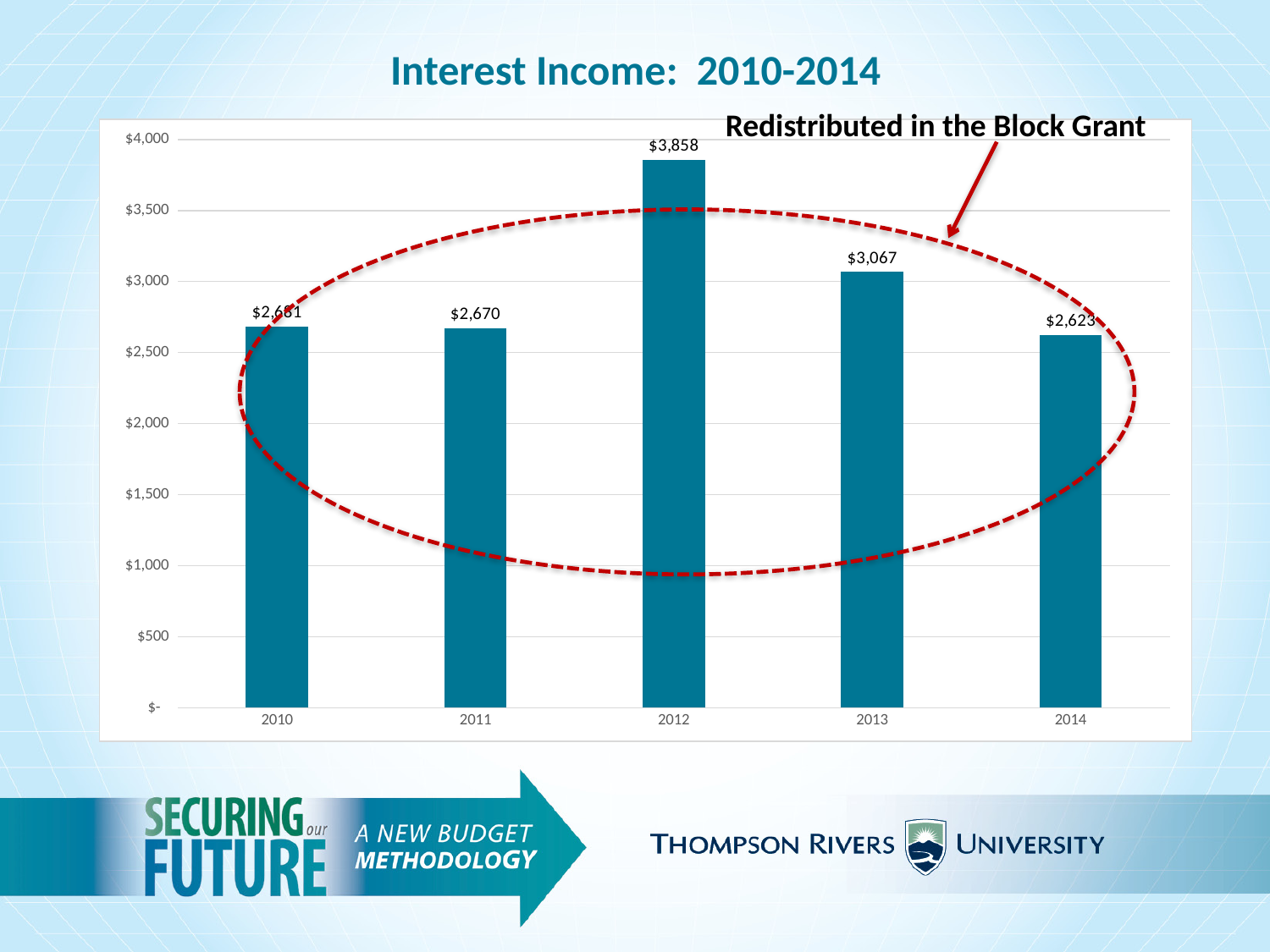
Is the value for 2010 greater or less than $2,500? greater What is the interest income value shown for 2012? $3,858 Which year has the larger interest income, 2013 or 2014? 2013 What is the difference between the 2013 and 2014 interest income values? $444 What is the interest income value shown for 2011? $2,670 Which year has the highest interest income? 2012 What kind of chart is shown on the slide? Bar chart What does the annotation with the red arrow say? Redistributed in the Block Grant What is the interest income value shown for 2014? $2,623 What is the interest income value shown for 2013? $3,067 What is the difference between the 2012 and 2013 interest income values? $791 How many years are shown on the x axis? 5